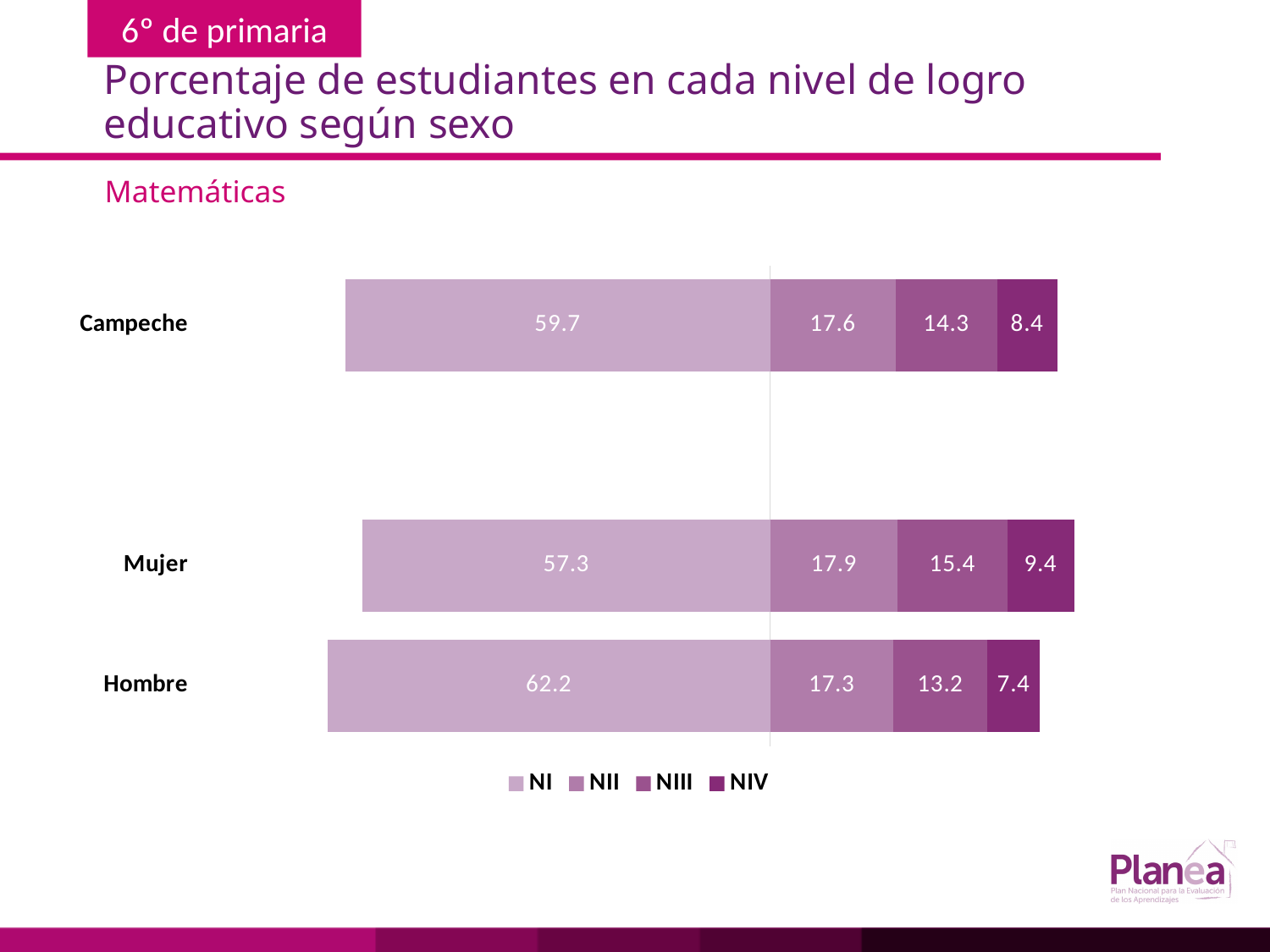
Which is larger, the NIII value for Mujer or the NIII value for Hombre? Mujer What is the NI value for Hombre? 62.2 What is the difference between the NI values for Hombre and Mujer? 4.9 Which category has the lowest NIV value? Hombre What is the total of the stacked bar for Campeche? 100.0 What is the NIII value for Campeche? 14.3 What kind of chart is shown on the slide? Stacked bar chart What is the NIV value for Mujer? 9.4 What is the NII value for Mujer? 17.9 How many series does the legend list? 4 Which category has the highest NI value? Hombre How many categories are shown on the chart? 3